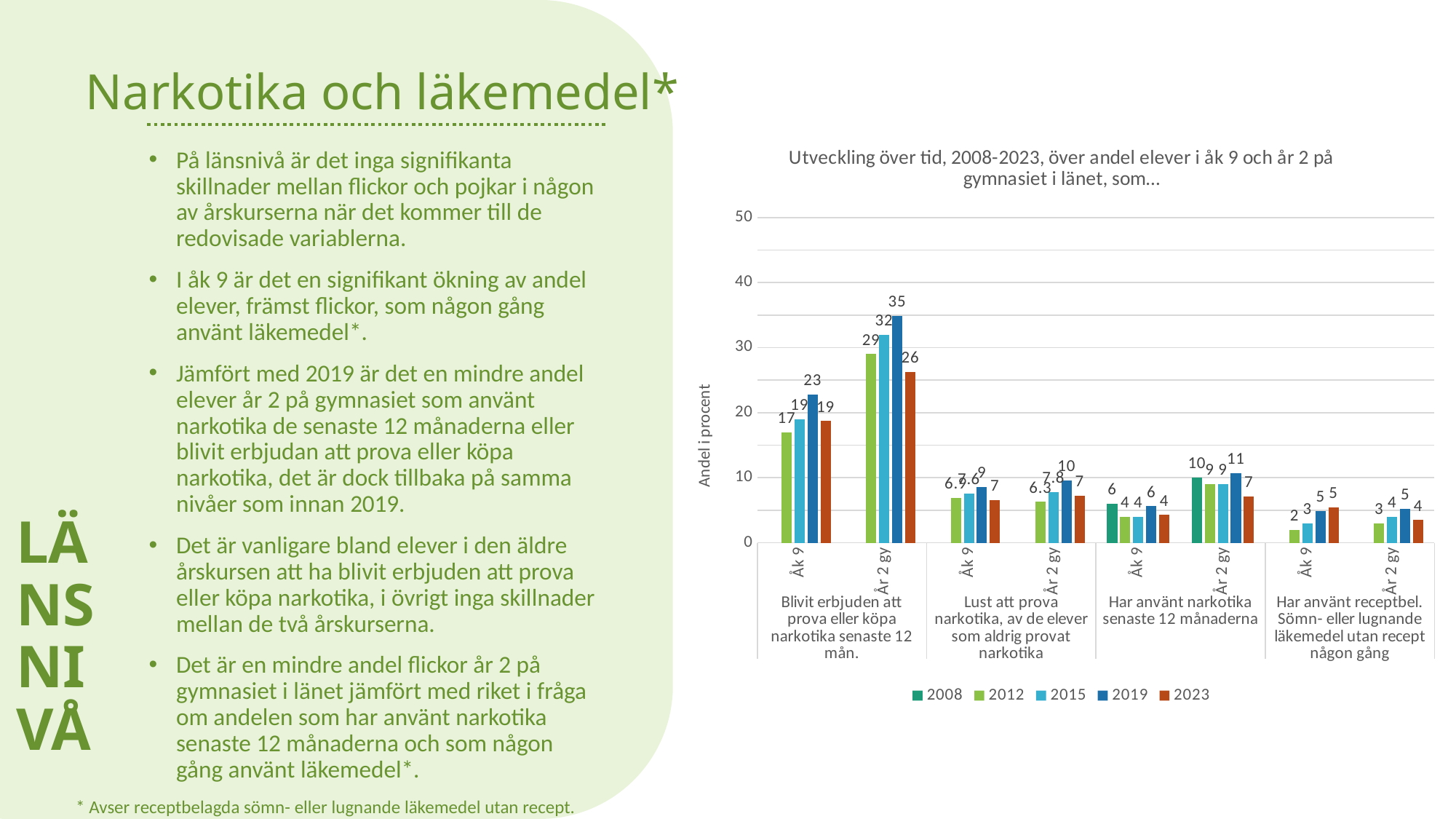
What is the 2019 value for År 2 gy in the 'Har använt narkotika senaste 12 månaderna' group? 11 What kind of chart is shown on the slide? Bar chart What is the 2023 value for År 2 gy in the 'Blivit erbjuden att prova eller köpa narkotika senaste 12 mån.' group? 26 In the 'Har använt narkotika senaste 12 månaderna' group, is the 2008 value for År 2 gy larger or smaller than the 2008 value for Åk 9? larger What is the 2019 value for Åk 9 in the 'Blivit erbjuden att prova eller köpa narkotika senaste 12 mån.' group? 23 What is the label of the y axis? Andel i procent How many main category groups are shown along the x axis? 4 What is the difference between the 2019 and 2023 values for År 2 gy in the 'Blivit erbjuden att prova eller köpa narkotika senaste 12 mån.' group? 9 How many series does the legend list? 5 What is the 2012 value for Åk 9 in the 'Har använt receptbel. Sömn- eller lugnande läkemedel utan recept någon gång' group? 2 Which year has the lowest value for År 2 gy in the 'Har använt narkotika senaste 12 månaderna' group? 2023 Which year has the highest value for År 2 gy in the 'Blivit erbjuden att prova eller köpa narkotika senaste 12 mån.' group? 2019